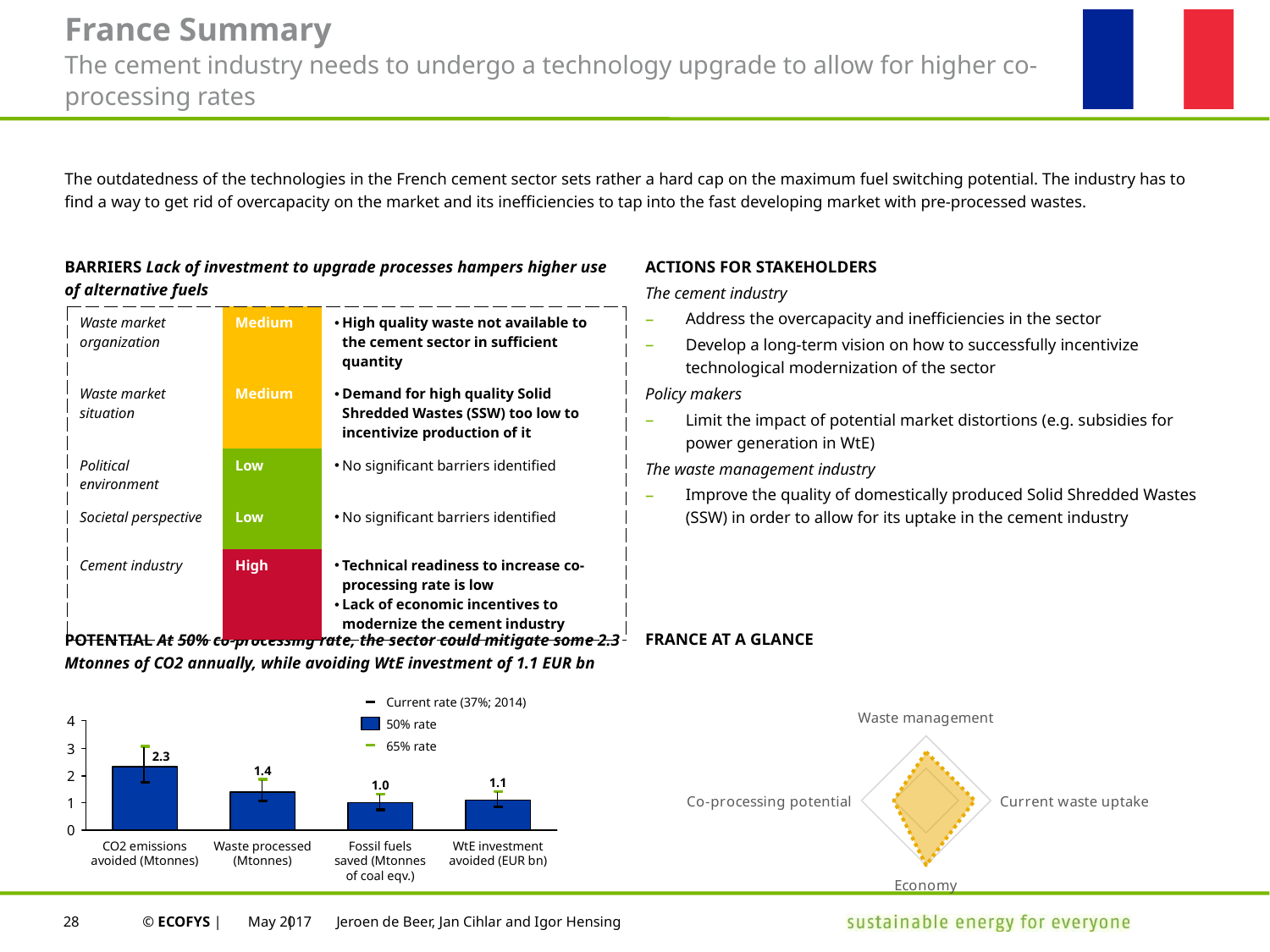
In the bar chart at the bottom left, which category has the lowest 50% rate value? Fossil fuels saved (Mtonnes of coal eqv.) What kind of chart is shown at the bottom left of the slide? Bar chart In the bar chart at the bottom left, what is the value for WtE investment avoided (EUR bn) at the 50% rate? 1.1 In the bar chart at the bottom left, what is the difference between the 50% rate values for CO2 emissions avoided and Waste processed? 0.9 In the bar chart at the bottom left, what is the value for Waste processed (Mtonnes) at the 50% rate? 1.4 How many categories are shown on the x axis of the bar chart at the bottom left? 4 How many entries does the legend of the bar chart at the bottom left list? 3 How many axes does the 'France at a glance' radar chart at the bottom right have? 4 In the bar chart at the bottom left, which is larger at the 50% rate: Waste processed (Mtonnes) or WtE investment avoided (EUR bn)? Waste processed (Mtonnes) In the bar chart at the bottom left, is the 50% rate value for CO2 emissions avoided greater or less than 2? greater In the bar chart at the bottom left, which category has the highest 50% rate value? CO2 emissions avoided (Mtonnes) In the bar chart at the bottom left, what is the value for CO2 emissions avoided (Mtonnes) at the 50% rate? 2.3